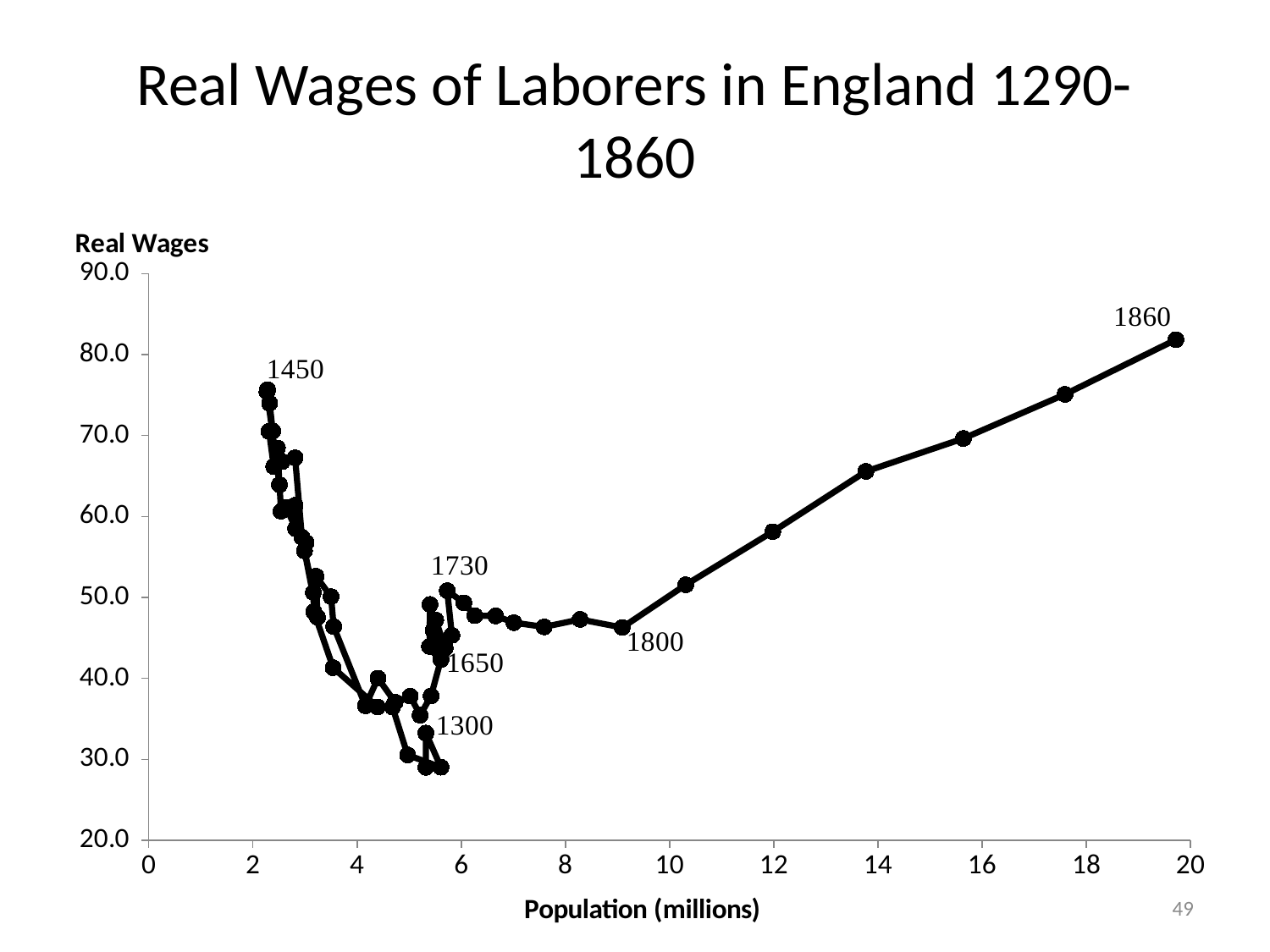
Is the real wage value for the point labeled 1450 greater or less than 70? greater Which labeled year has the higher real wage, 1300 or 1800? 1800 Is the population for the point labeled 1860 greater or less than 18 million? greater What kind of chart is shown on the slide? scatter plot with connected points Which labeled year has the higher real wage, 1860 or 1450? 1860 Is the real wage value for the point labeled 1800 greater or less than 50? less What is the title of the chart? Real Wages of Laborers in England 1290-1860 What is the label of the horizontal axis? Population (millions) Among the labeled years on the chart, which has the lowest real wage? 1300